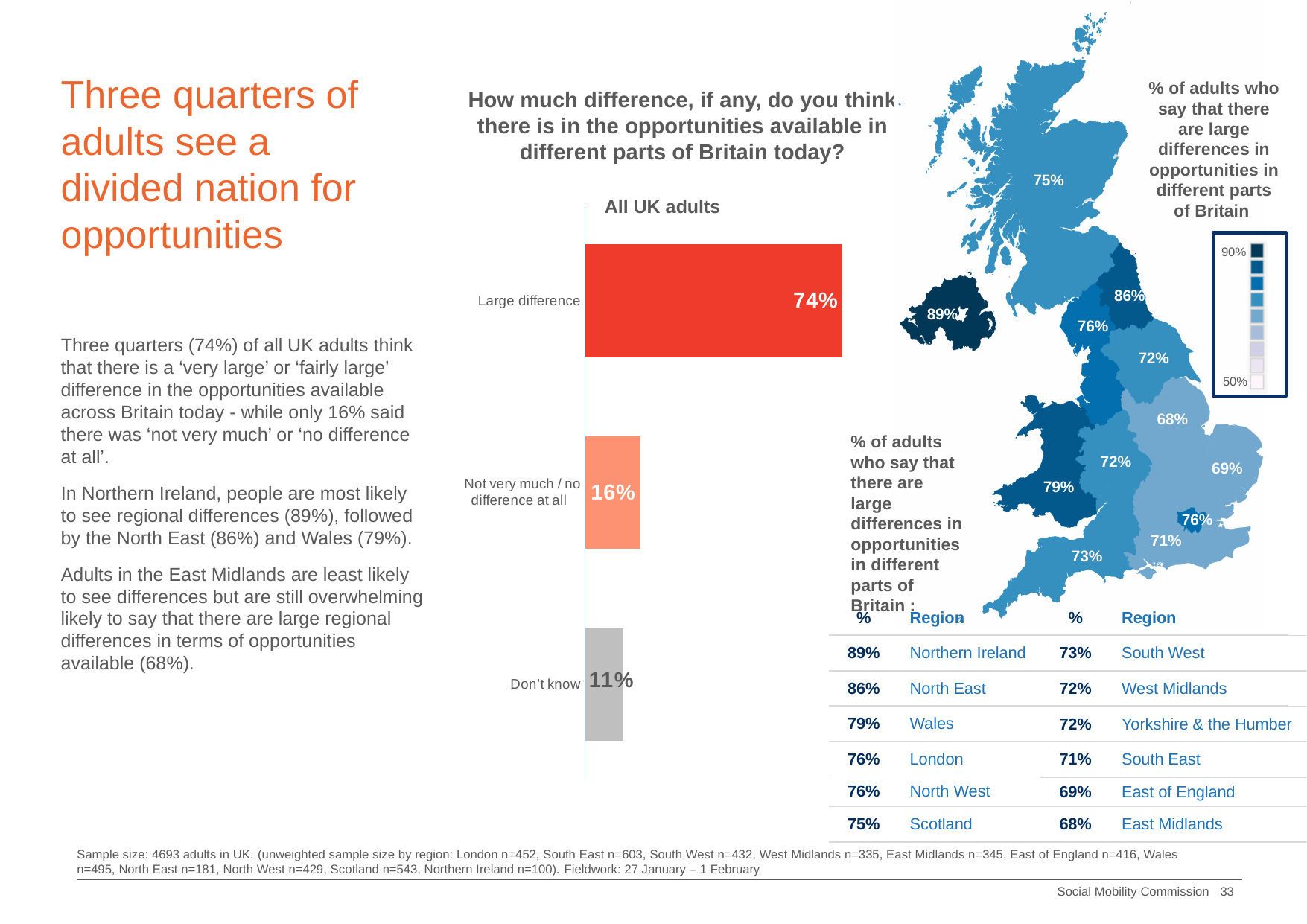
On the map, what percentage of adults in Wales say there are large differences in opportunities? 79% In the bar chart, what is the difference between the 'Large difference' value and the 'Not very much / no difference at all' value? 58 percentage points In the bar chart, which response category has the lowest value? Don't know What type of chart is used to show the 'All UK adults' responses? Bar chart On the map, which region has the highest percentage of adults saying there are large differences in opportunities? Northern Ireland In the bar chart, what percentage of all UK adults say there is a large difference in opportunities? 74% On the map, which has the larger value: Scotland or the North East? North East On the map, which region has the lowest percentage of adults saying there are large differences in opportunities? East Midlands How many response categories are shown in the bar chart? 3 In the bar chart, what percentage of all UK adults answered 'Don't know'? 11% In the bar chart, what percentage of all UK adults say there is not very much or no difference at all? 16% In the bar chart, which response category has the highest value? Large difference